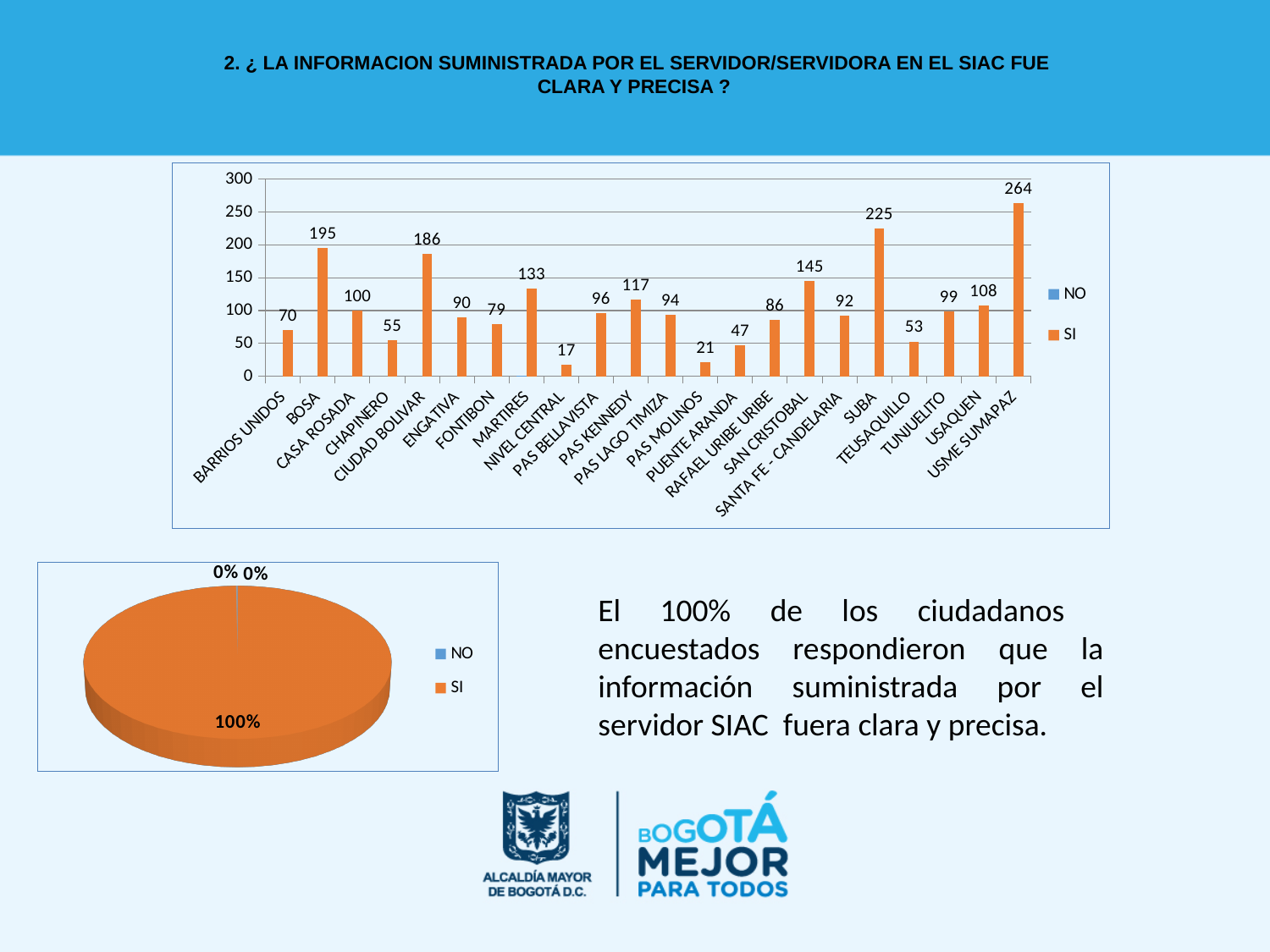
In the top bar chart, which has a larger SI value, SAN CRISTOBAL or MARTIRES? SAN CRISTOBAL How many series does the legend of the top bar chart list? 2 In the top bar chart, what is the SI value for SUBA? 225 What kind of chart is the chart at the bottom left of the slide? pie chart In the top bar chart, what is the difference between the SI values for BOSA and CIUDAD BOLIVAR? 9 How many categories are shown on the x axis of the top bar chart? 22 In the top bar chart, is the SI value for USME SUMAPAZ greater or less than 250? greater In the pie chart at the bottom left, what share does SI have? 100% In the top bar chart, which category has the lowest SI value? NIVEL CENTRAL In the top bar chart, which category has the highest SI value? USME SUMAPAZ In the top bar chart, what is the SI value for NIVEL CENTRAL? 17 What kind of chart is the chart at the top of the slide? bar chart